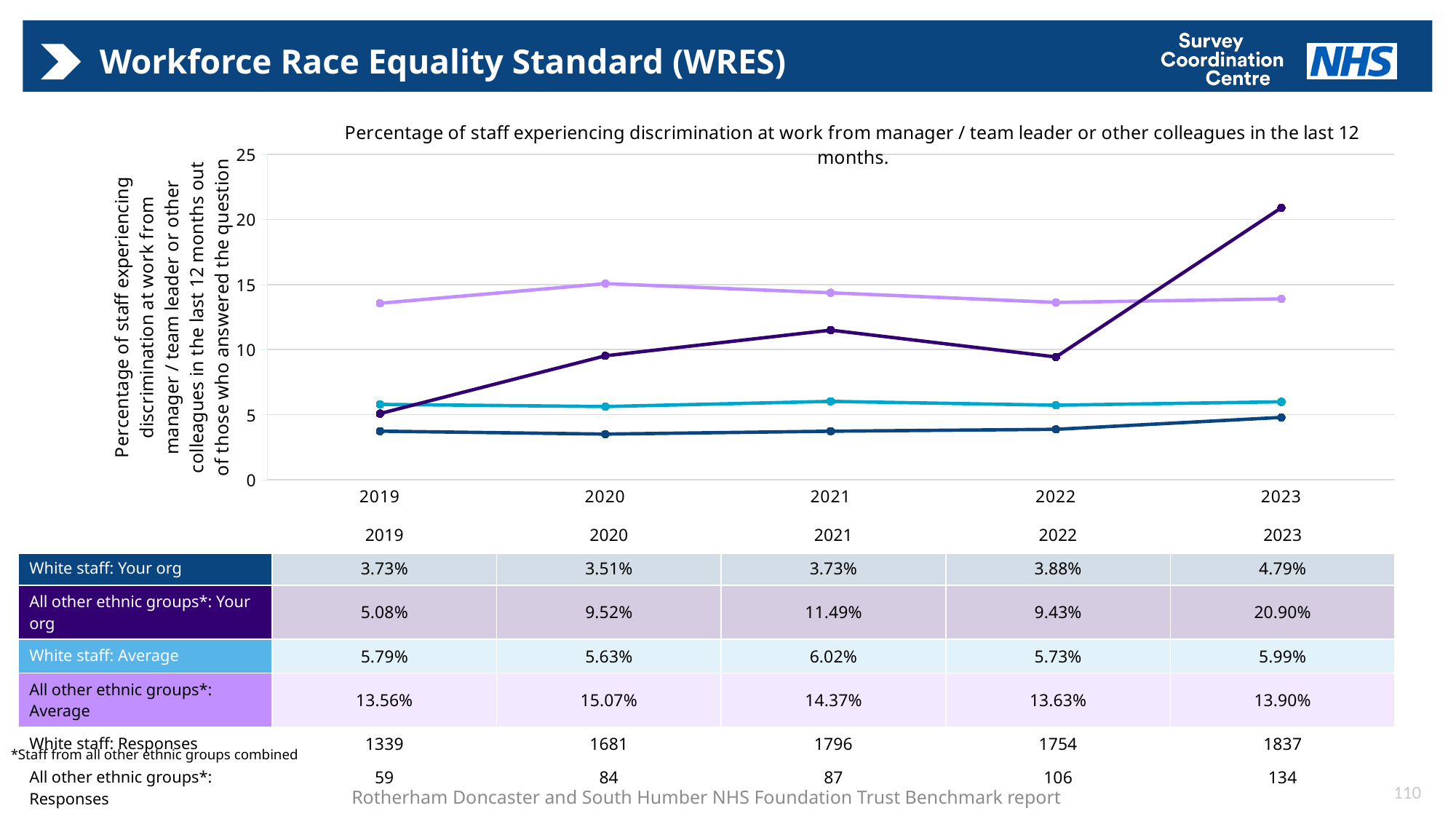
In 2022, which is larger: 'All other ethnic groups*: Average' or 'All other ethnic groups*: Your org'? All other ethnic groups*: Average Is the value for 'All other ethnic groups*: Your org' in 2023 greater or less than 20? greater What type of chart is shown on the slide? Line chart How many responses were there from 'All other ethnic groups*' in 2023? 134 What is the value for 'All other ethnic groups*: Your org' in 2023? 20.90% What is the value for 'All other ethnic groups*: Average' in 2019? 13.56% What is the difference between 'All other ethnic groups*: Your org' and 'White staff: Your org' in 2023? 16.11% How many years are plotted along the x axis of the chart? 5 What is the value for 'White staff: Your org' in 2020? 3.51% In which year is the value for 'All other ethnic groups*: Your org' highest? 2023 What is the value for 'White staff: Average' in 2021? 6.02% In which year is the value for 'White staff: Your org' lowest? 2020